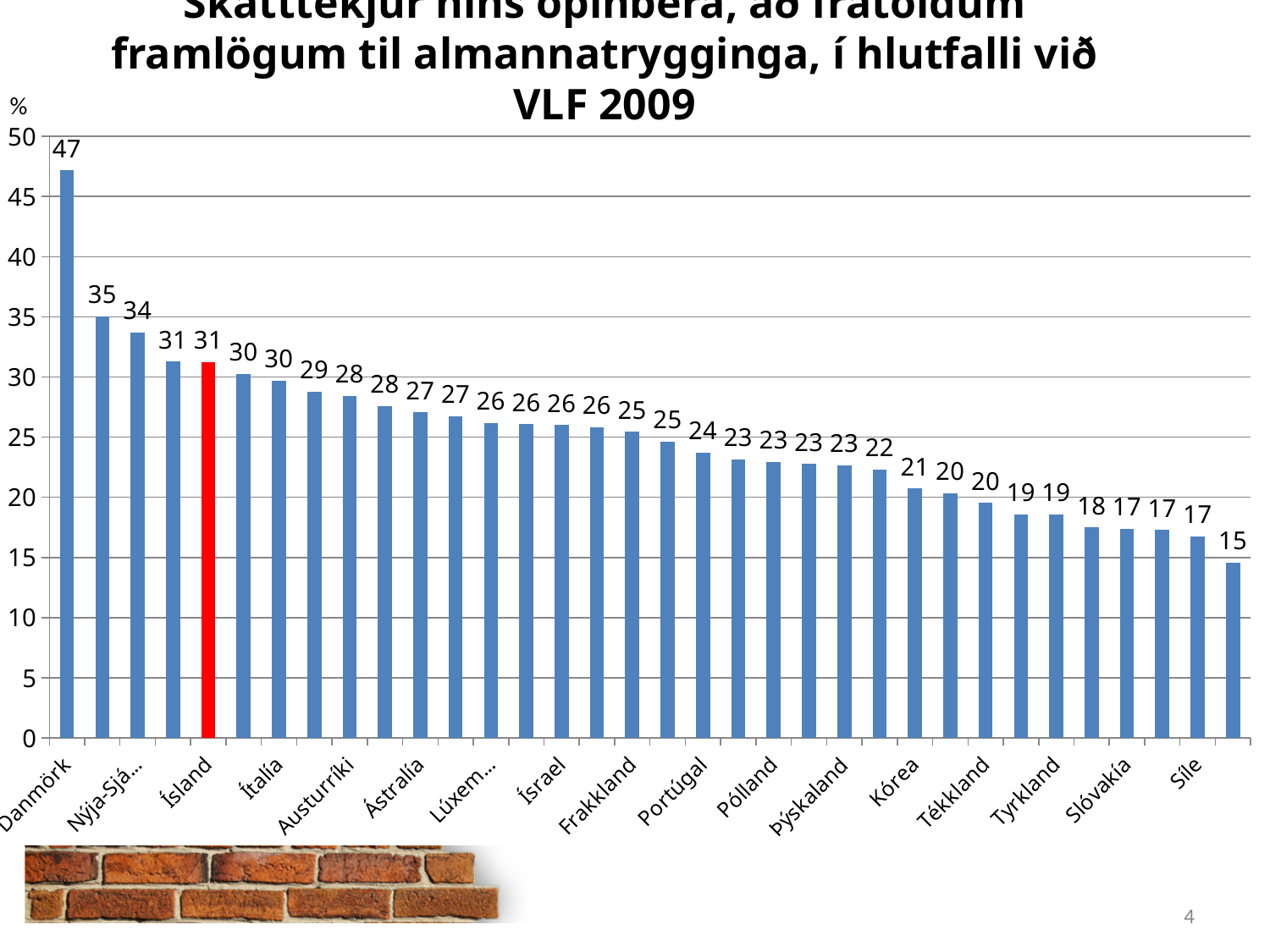
Which country has the highest value? Danmörk What is the value for Slóvakía? 17 What is the value for Austurríki? 28 What is the value for Ítalía? 30 What is the lowest value shown on the chart? 15 What is the difference between the values for Danmörk and Ísland? 16 What is the value for Ísland (the red bar)? 31 What is the value for Pólland? 23 Is the value for Síle greater or less than 20? less Which is larger, the value for Ísland or the value for Tyrkland? Ísland Which country is highlighted with a red bar? Ísland What is the value for Danmörk? 47